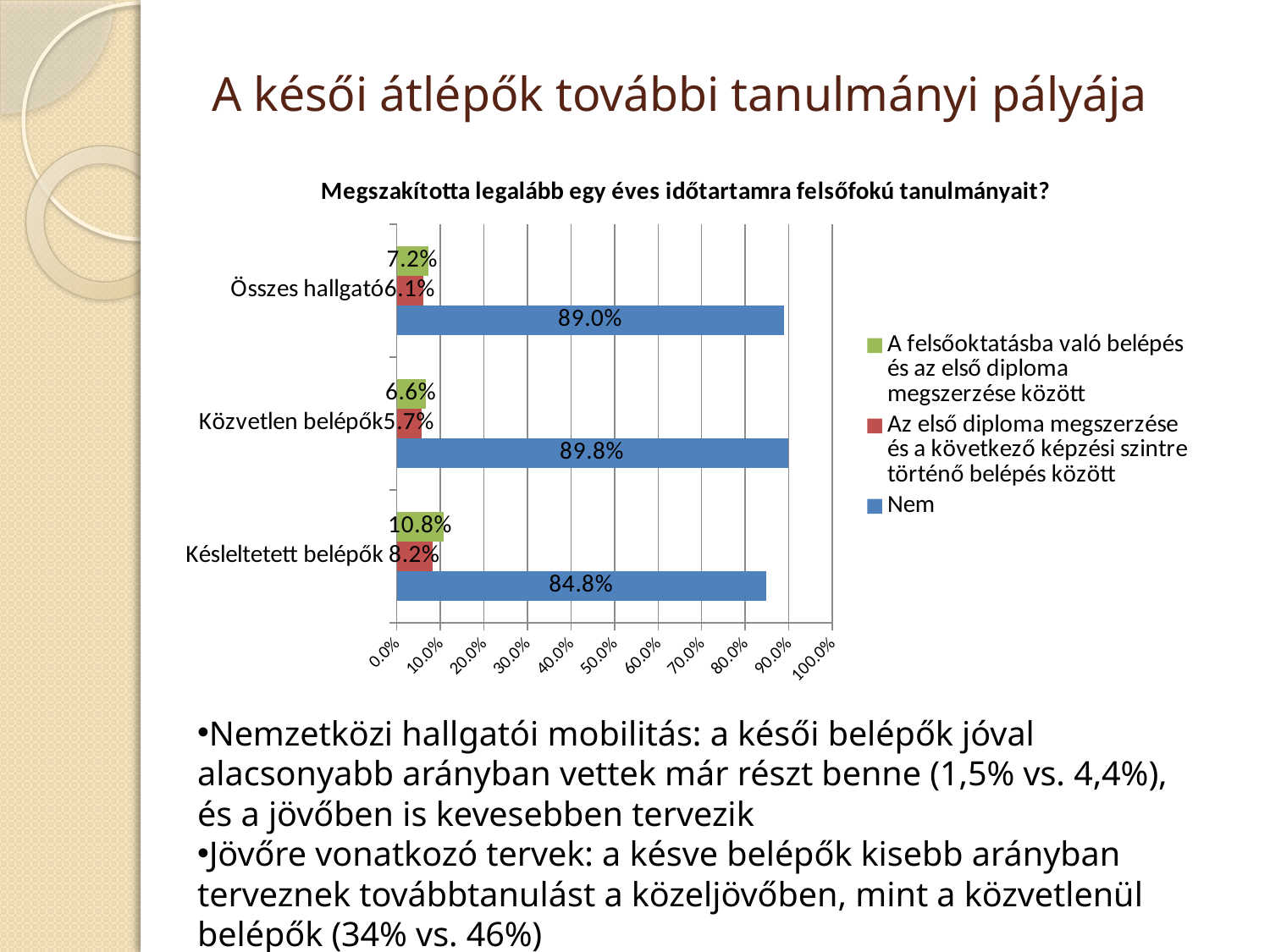
How many categories are shown on the y axis of the chart? 3 What type of chart is shown on the slide? bar chart What is the value of "A felsőoktatásba való belépés és az első diploma megszerzése között" for Késleltetett belépők? 10.8% How many series does the legend list? 3 What is the value of "Az első diploma megszerzése és a következő képzési szintre történő belépés között" for Összes hallgató? 6.1% Which category has the lowest value for "Nem"? Késleltetett belépők Which category has the highest value for "Nem"? Közvetlen belépők What is the difference between the "Nem" values for Közvetlen belépők and Késleltetett belépők? 5.0% What is the title of the chart? Megszakította legalább egy éves időtartamra felsőfokú tanulmányait? What is the value of "Nem" for Közvetlen belépők? 89.8% What is the value of "Nem" for Késleltetett belépők? 84.8% Which is larger: the green series value for Késleltetett belépők or for Közvetlen belépők? Késleltetett belépők